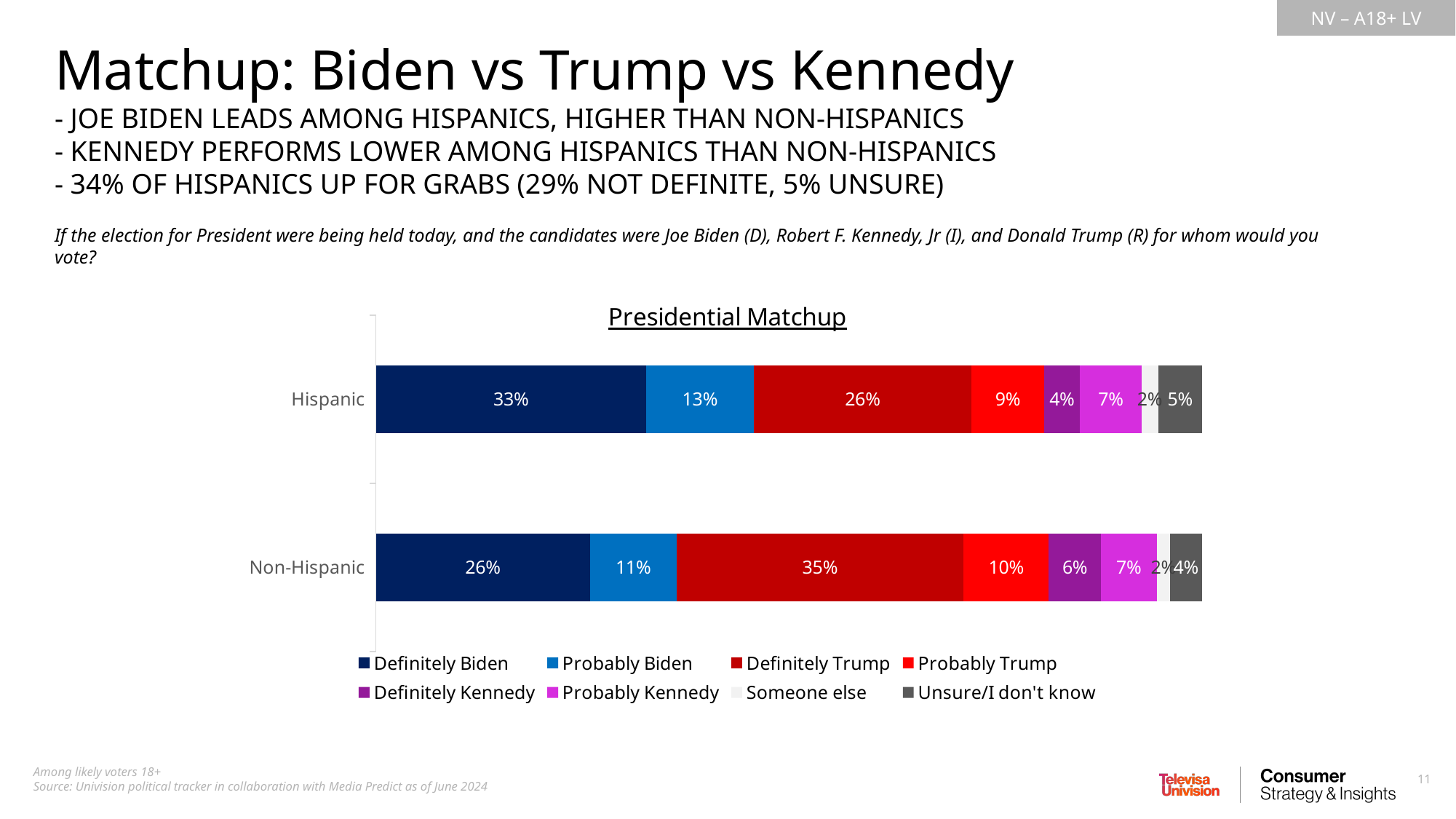
Which response is the largest segment of the Non-Hispanic bar? Definitely Trump Which response is the smallest segment of the Hispanic bar? Someone else Which group has the larger Definitely Biden value, Hispanic or Non-Hispanic? Hispanic What kind of chart is the Presidential Matchup chart? Stacked bar chart How many percentage points higher is Definitely Trump among Non-Hispanic voters than among Hispanic voters? 9 percentage points What is the Definitely Trump value for Non-Hispanic voters? 35% What share of Non-Hispanic voters answered Unsure/I don't know? 4% How many series does the legend of the Presidential Matchup chart list? 8 What percentage of Hispanic likely voters say they would definitely vote for Biden? 33% What is the difference between the Probably Biden values for Hispanic and Non-Hispanic voters? 2 percentage points What is the Probably Kennedy value for Hispanic voters? 7% How many groups (bars) are shown in the Presidential Matchup chart? 2